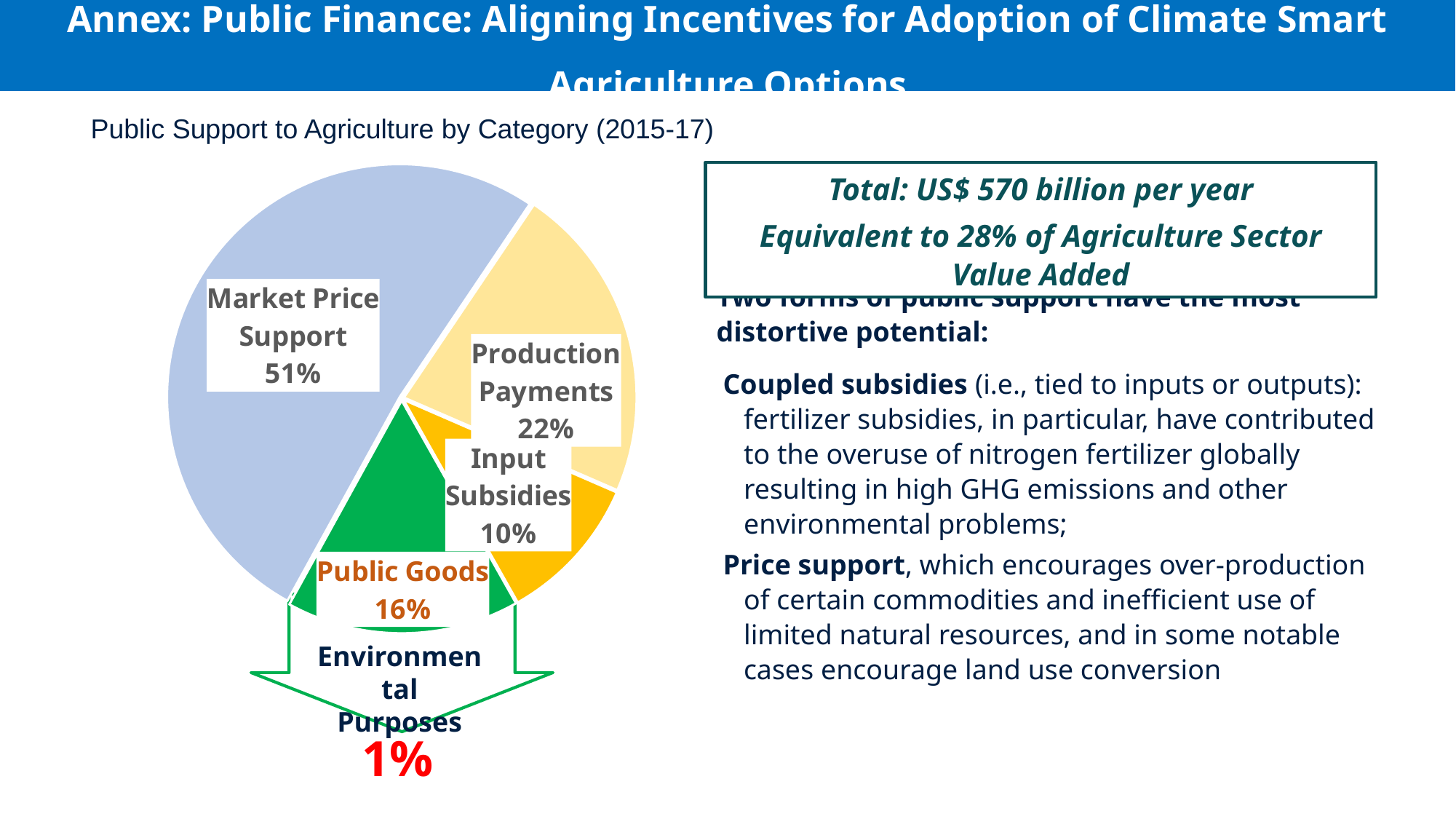
What type of chart is shown on the slide? pie chart Which category has the smallest share of the pie? Input Subsidies What share of public support to agriculture is Input Subsidies? 10% What share of public support to agriculture is Production Payments? 22% How many percentage points larger is Market Price Support than Production Payments? 29 Which category has the largest share of the pie? Market Price Support What is the combined share of Production Payments and Input Subsidies? 32% What share of public support to agriculture is Public Goods? 16% What share of public support to agriculture goes to Environmental Purposes? 1% What is the title of the chart? Public Support to Agriculture by Category (2015-17) What share of public support to agriculture is Market Price Support? 51% Which is larger, Public Goods or Input Subsidies? Public Goods